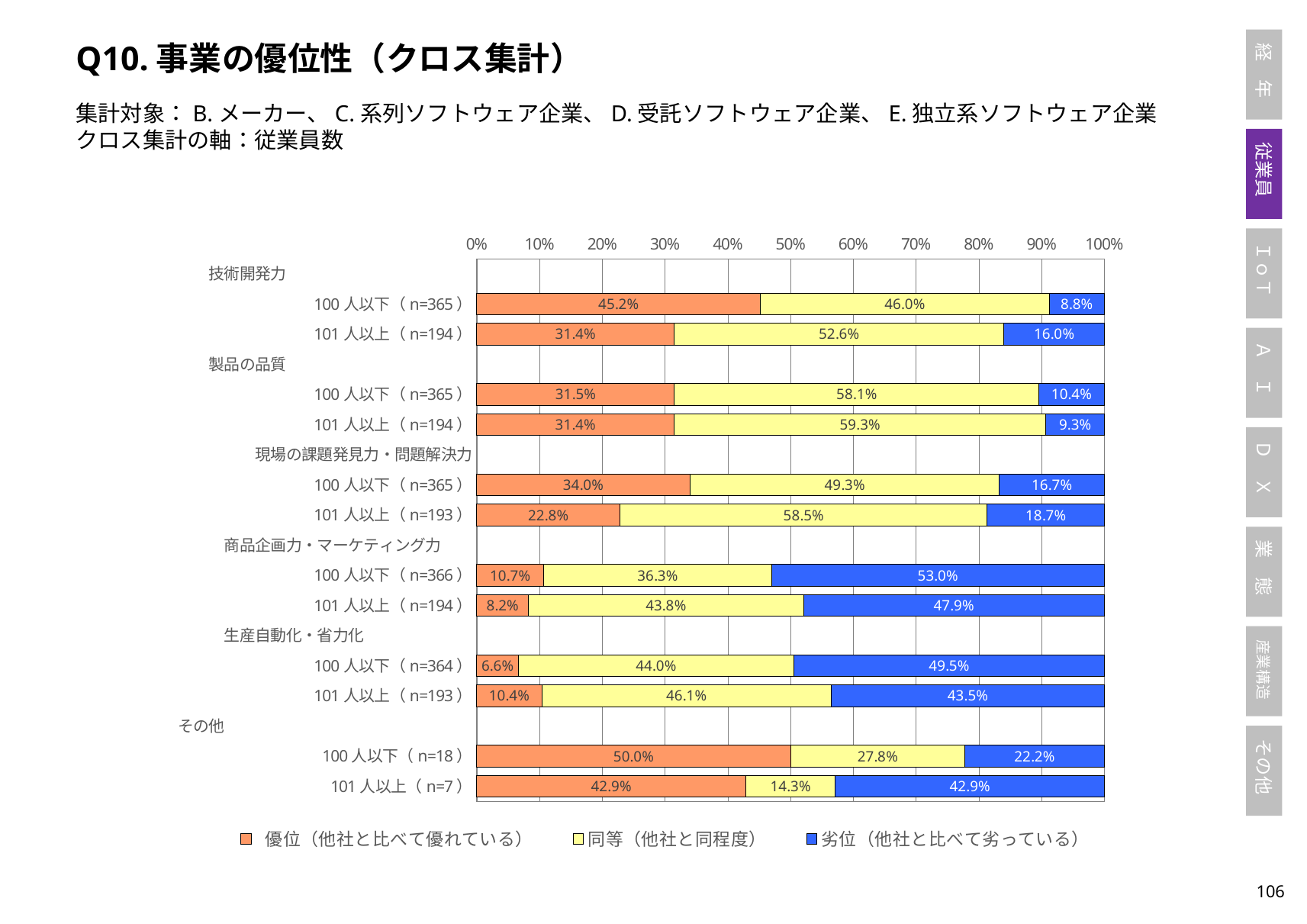
What is the 劣位 value for 技術開発力, 101人以上 (n=194)? 16.0% What is the difference between the 劣位 values for 現場の課題発見力・問題解決力, 101人以上 (n=193) and 100人以下 (n=365)? 2.0% Which series is shown in blue in the legend? 劣位（他社と比べて劣っている） Which bar has the lowest 優位 value? 生産自動化・省力化, 100人以下 (n=364) Which bar has the highest 優位 value? その他, 100人以下 (n=18) Which is larger: the 同等 value for 製品の品質, 100人以下 (n=365) or the 同等 value for 技術開発力, 100人以下 (n=365)? 製品の品質, 100人以下 (n=365) What is the 同等 value for 製品の品質, 101人以上 (n=194)? 59.3% What is the 劣位 value for 商品企画力・マーケティング力, 100人以下 (n=366)? 53.0% What is the 優位 value for 生産自動化・省力化, 100人以下 (n=364)? 6.6% What is the 優位 value for 技術開発力, 100人以下 (n=365)? 45.2% What kind of chart is shown on the slide? stacked bar chart How many series does the legend list? 3